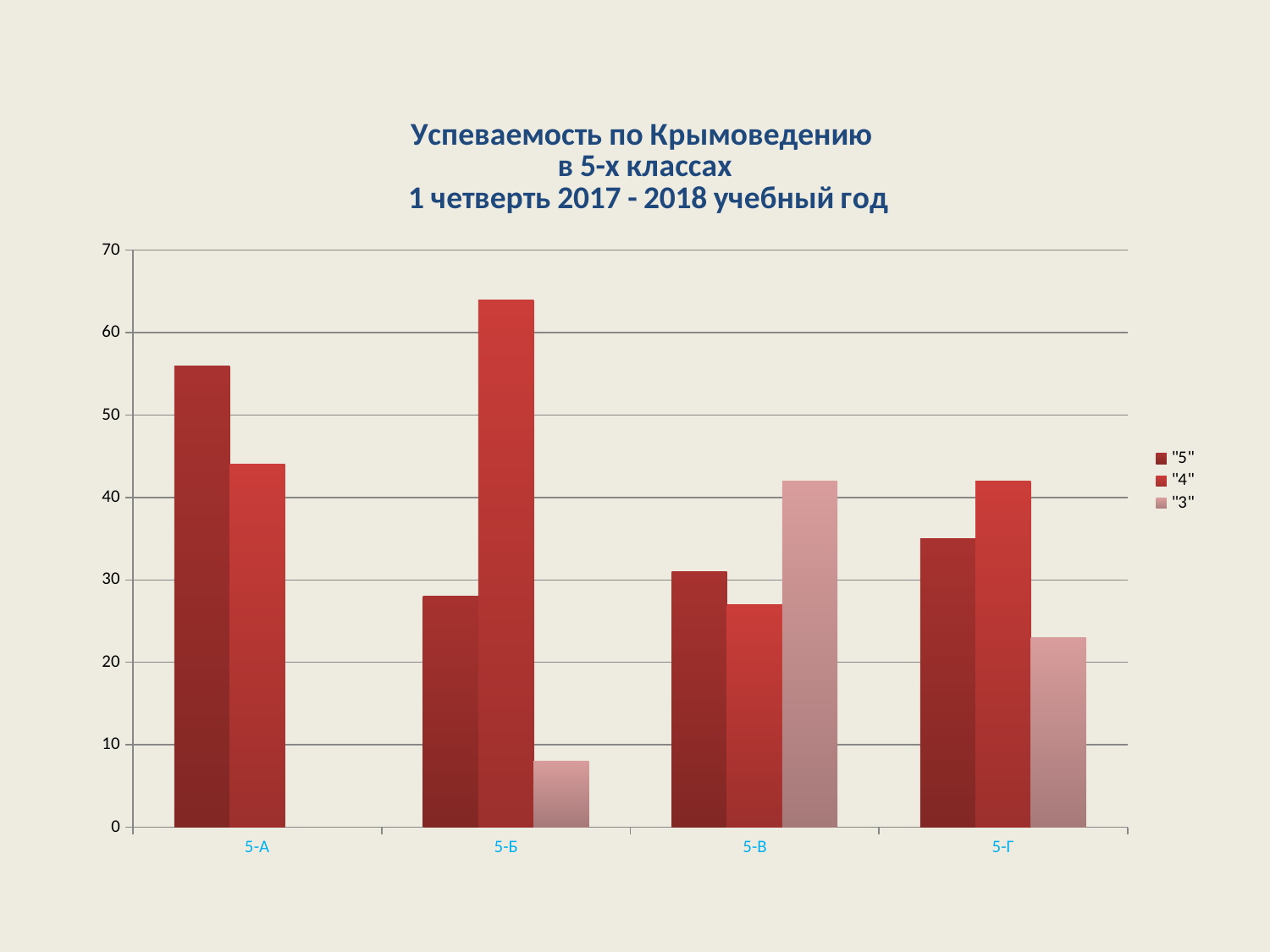
Which class has the highest value for the "4" series? 5-Б What is the first line of the chart title? Успеваемость по Крымоведению How many series does the legend list? 3 Is the value for the "3" series in class 5-Б greater or less than 10? less In class 5-В, which series has the larger value: "5" or "3"? "3" Which class has the lowest value for the "5" series? 5-Б Is the value for the "4" series in class 5-Б greater or less than 60? greater In class 5-Г, which series has the larger value: "4" or "3"? "4" Is the value for the "5" series in class 5-А greater or less than 50? greater How many classes (categories) are shown on the x axis? 4 Which class has the highest value for the "5" series? 5-А What kind of chart is shown on the slide? bar chart